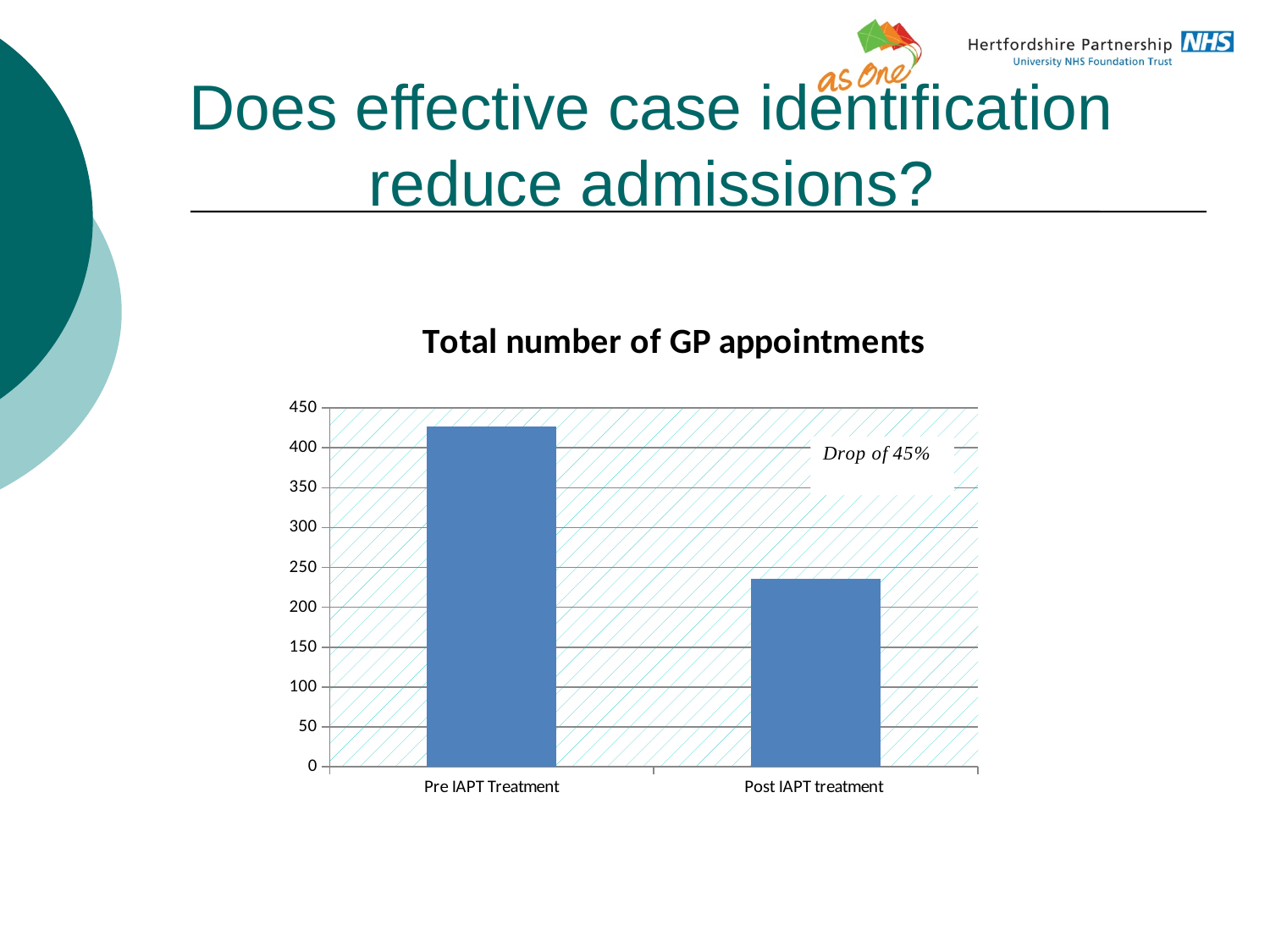
Which is larger, the value for Pre IAPT Treatment or Post IAPT treatment? Pre IAPT Treatment Is the value for Post IAPT treatment greater or less than 250? less How many categories are plotted in the chart? 2 Which category has the lowest value? Post IAPT treatment Do the values rise or fall from Pre IAPT Treatment to Post IAPT treatment? fall What type of chart is shown on the slide? bar chart Is the value for Post IAPT treatment greater or less than 200? greater Which category has the highest value? Pre IAPT Treatment What is the title of the chart? Total number of GP appointments What percentage drop is annotated on the chart? Drop of 45% What is the maximum value shown on the vertical axis? 450 Is the value for Pre IAPT Treatment greater or less than 400? greater